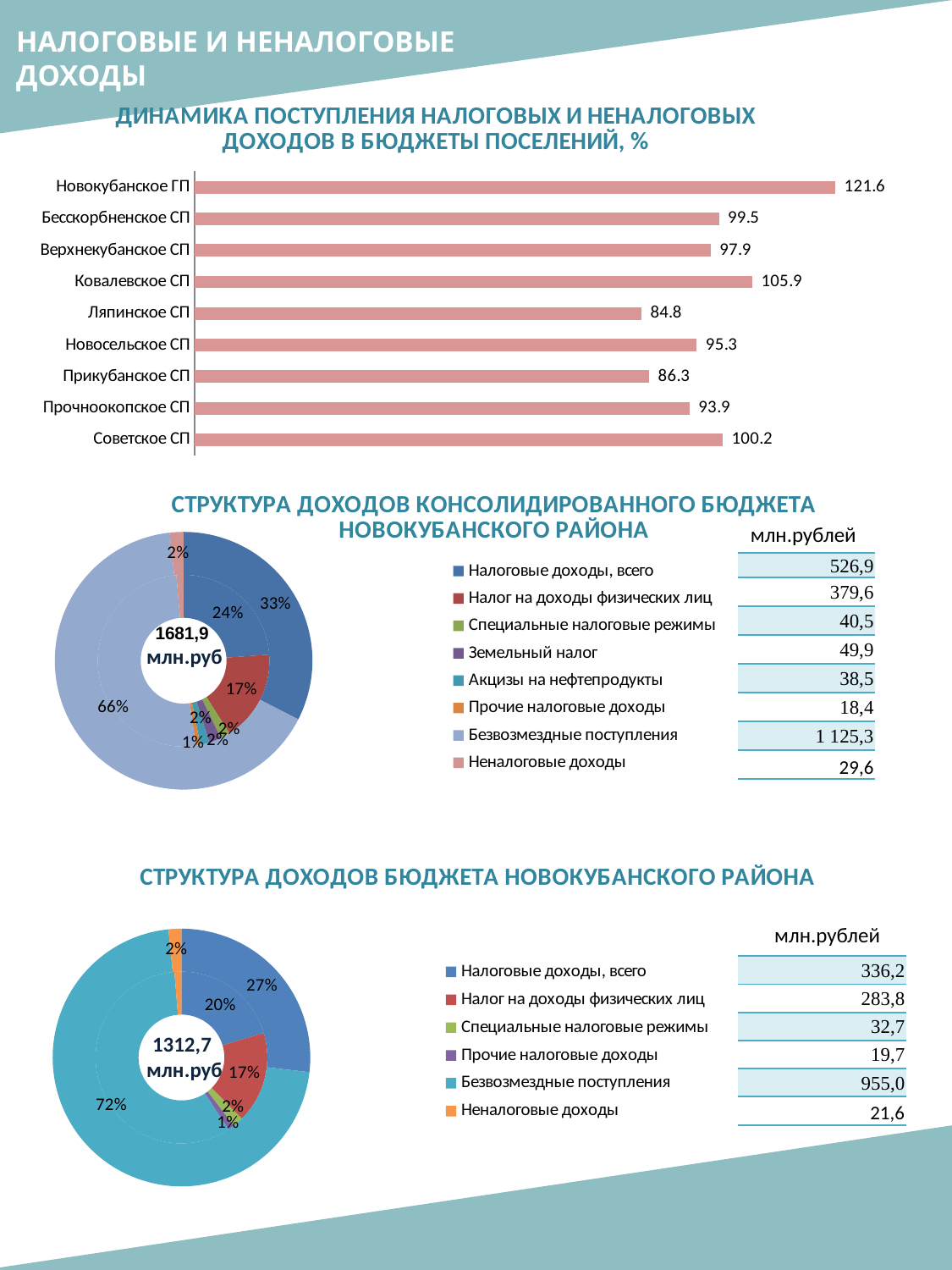
In the bar chart 'Динамика поступления налоговых и неналоговых доходов в бюджеты поселений, %', what is the value for Ляпинское СП? 84.8 In the bar chart 'Динамика поступления налоговых и неналоговых доходов в бюджеты поселений, %', which is larger: the value for Ковалевское СП or Советское СП? Ковалевское СП In the chart 'Структура доходов консолидированного бюджета Новокубанского района', what is the value in млн.рублей for Налог на доходы физических лиц? 379,6 In the bar chart 'Динамика поступления налоговых и неналоговых доходов в бюджеты поселений, %', what is the difference between the values for Новокубанское ГП and Ляпинское СП? 36.8 What type of chart is used for 'Динамика поступления налоговых и неналоговых доходов в бюджеты поселений, %'? Bar chart In the bar chart 'Динамика поступления налоговых и неналоговых доходов в бюджеты поселений, %', which settlement has the lowest value? Ляпинское СП In the bar chart 'Динамика поступления налоговых и неналоговых доходов в бюджеты поселений, %', what is the value for Новокубанское ГП? 121.6 How many settlements are shown in the bar chart 'Динамика поступления налоговых и неналоговых доходов в бюджеты поселений, %'? 9 How many entries does the legend list in the chart 'Структура доходов бюджета Новокубанского района'? 6 In the chart 'Структура доходов консолидированного бюджета Новокубанского района', what share of the pie is Безвозмездные поступления? 66% In the chart 'Структура доходов бюджета Новокубанского района', what is the value in млн.рублей for Безвозмездные поступления? 955,0 In the bar chart 'Динамика поступления налоговых и неналоговых доходов в бюджеты поселений, %', which settlement has the highest value? Новокубанское ГП